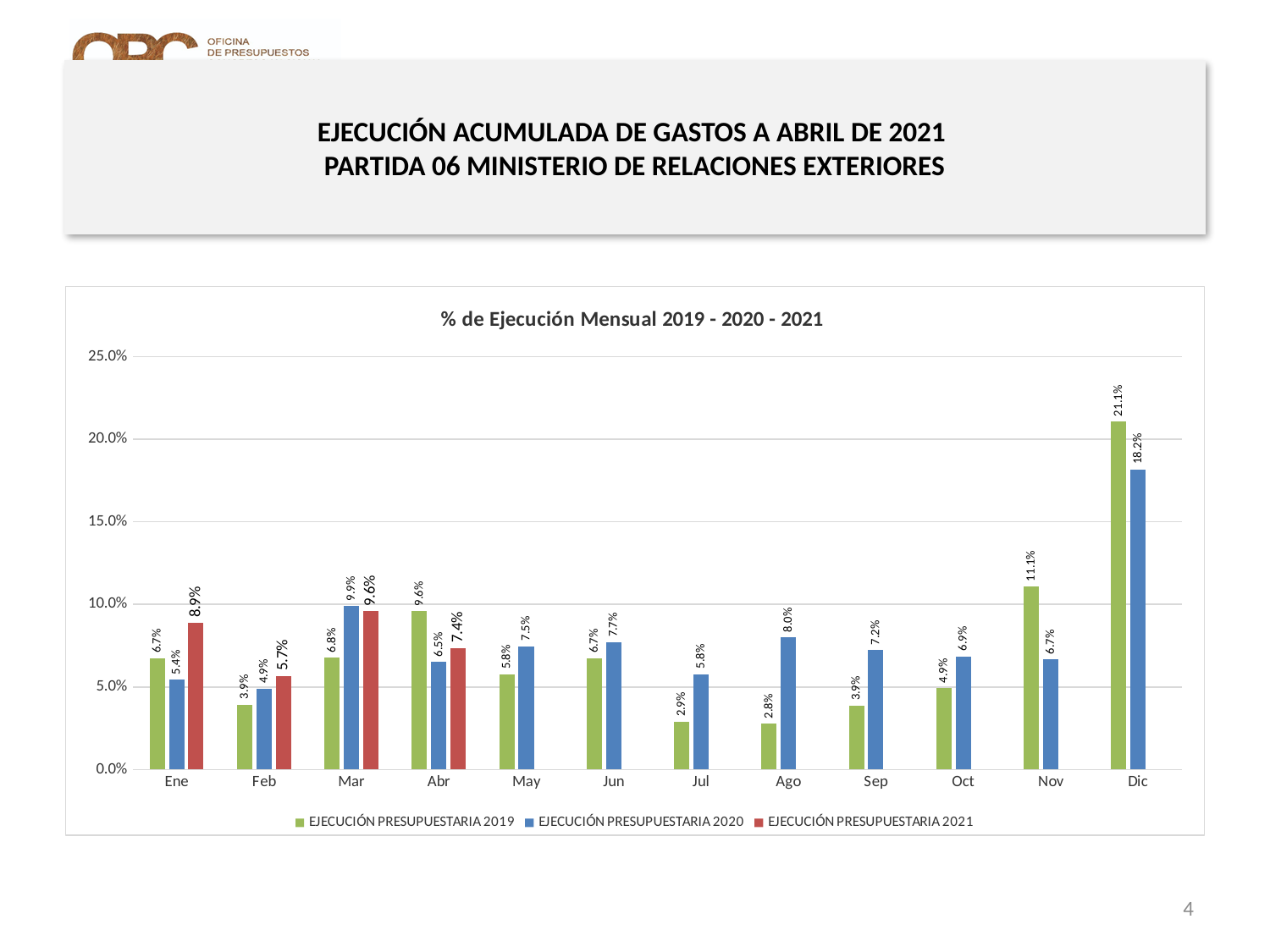
What is the value for EJECUCIÓN PRESUPUESTARIA 2019 in Dic? 21.1% Which month has the lowest value for EJECUCIÓN PRESUPUESTARIA 2019? Ago Which is larger in Abr: EJECUCIÓN PRESUPUESTARIA 2019 or EJECUCIÓN PRESUPUESTARIA 2021? EJECUCIÓN PRESUPUESTARIA 2019 Which month has the highest value for EJECUCIÓN PRESUPUESTARIA 2019? Dic What kind of chart is shown on the slide? Bar chart What is the value for EJECUCIÓN PRESUPUESTARIA 2020 in Mar? 9.9% How many months are shown on the x axis? 12 What is the title of the chart? % de Ejecución Mensual 2019 - 2020 - 2021 What is the value for EJECUCIÓN PRESUPUESTARIA 2021 in Ene? 8.9% How many series does the legend list? 3 What is the difference between EJECUCIÓN PRESUPUESTARIA 2019 and EJECUCIÓN PRESUPUESTARIA 2020 in Dic? 2.9% Is the value for EJECUCIÓN PRESUPUESTARIA 2020 in Dic greater or less than 15.0%? greater